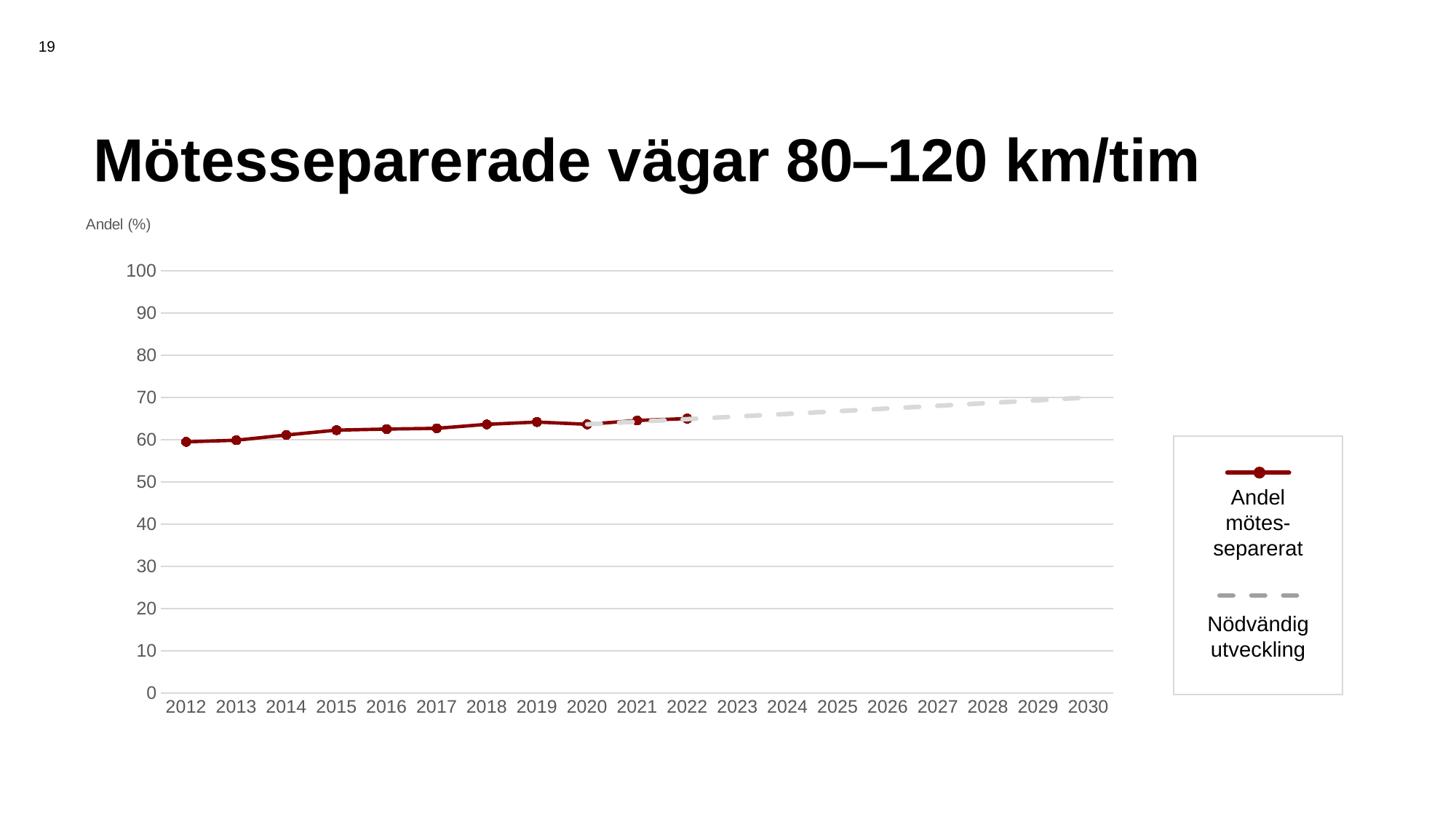
How many years are labelled on the x axis? 19 Does the 'Andel mötesseparerat' line generally rise or fall from 2012 to 2022? rise Is the value of the 'Nödvändig utveckling' line in 2030 greater or less than 60? greater What are the two series named in the legend? Andel mötesseparerat; Nödvändig utveckling What is the title of the chart on the slide? Mötesseparerade vägar 80–120 km/tim Is the value for 'Andel mötesseparerat' in 2022 greater or less than 70? less Which is larger, the value for 'Andel mötesseparerat' in 2012 or in 2022? 2022 What kind of chart is shown on the slide? line chart How many series does the legend list? 2 Is the value for 'Andel mötesseparerat' in 2012 greater or less than 50? greater In which year does the dashed 'Nödvändig utveckling' line end? 2030